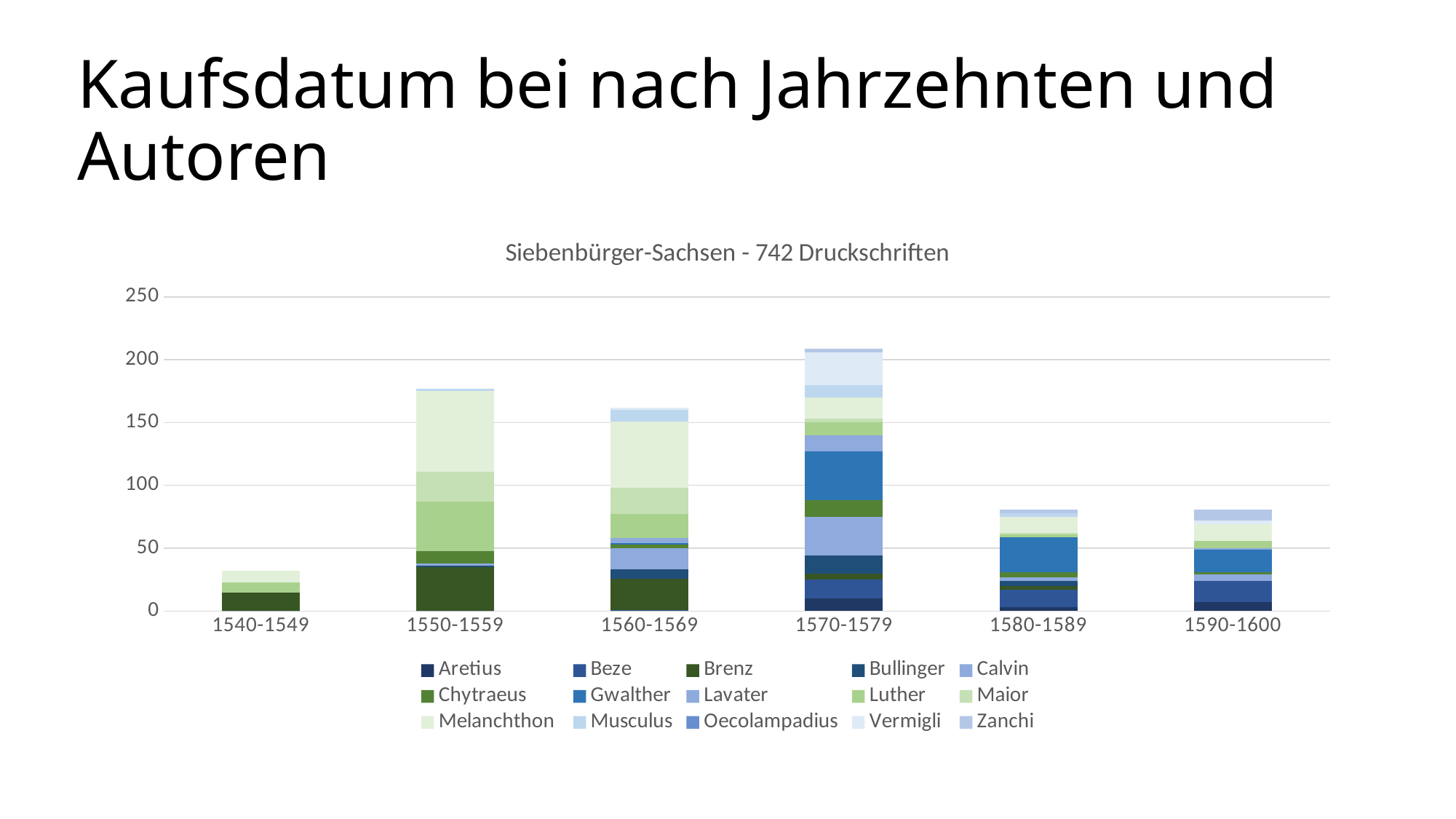
How many decade categories are shown on the x axis? 6 Is the total for 1540-1549 greater or less than 50? less Is the total for 1570-1579 greater or less than 200? greater Which stacked bar is taller, 1550-1559 or 1560-1569? 1550-1559 Is the total for 1550-1559 greater or less than 150? greater What kind of chart is shown on the slide? Stacked bar chart How many authors (series) does the legend list? 15 Which decade has the shortest stacked bar? 1540-1549 Which decade has the tallest stacked bar? 1570-1579 Does the total rise or fall from 1570-1579 to 1580-1589? fall What is the title of the chart? Siebenbürger-Sachsen - 742 Druckschriften